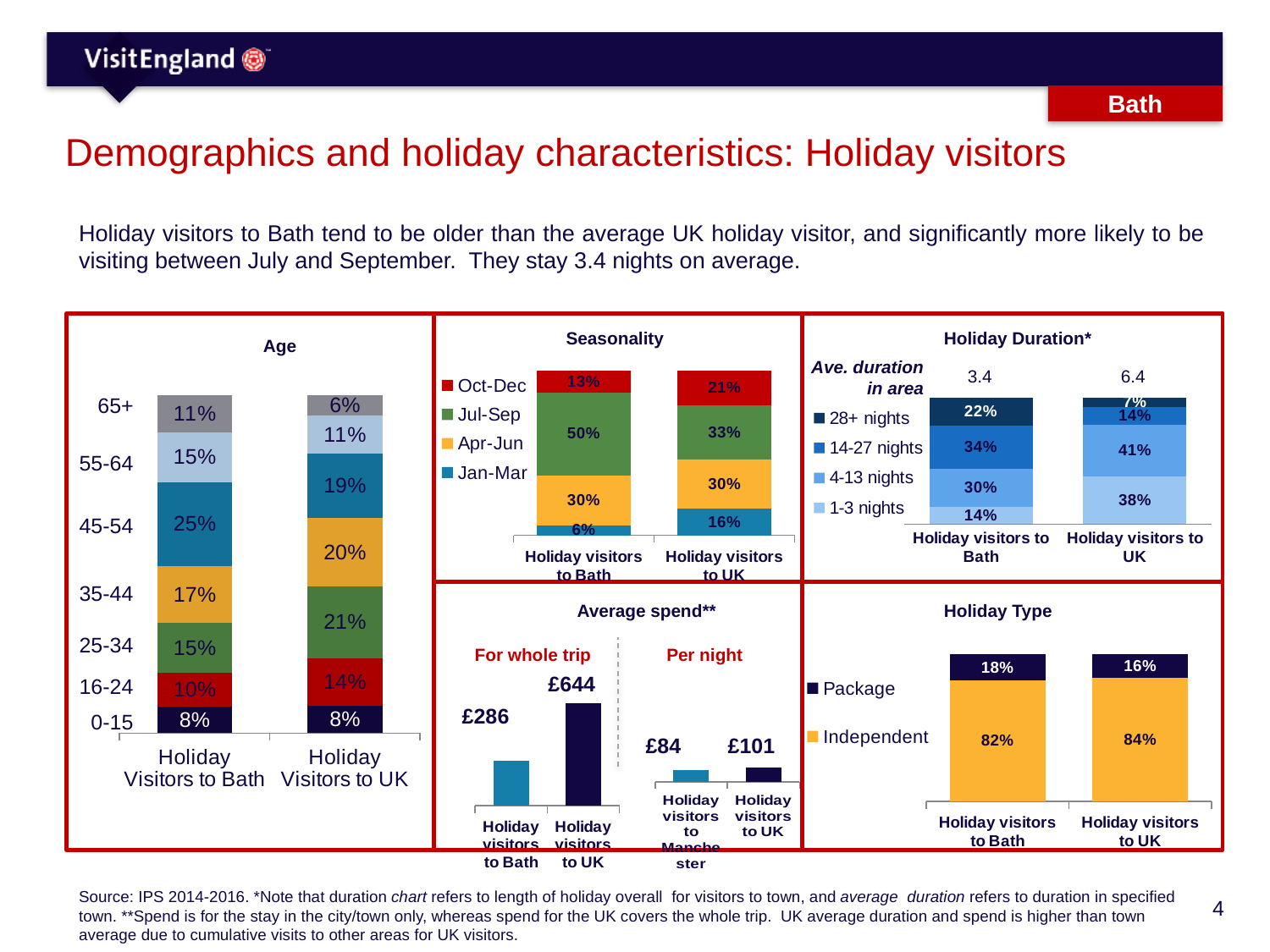
In the Holiday Duration chart, what is the average duration in area for holiday visitors to Bath? 3.4 In the Seasonality chart, which is larger: the Jan-Mar share for holiday visitors to Bath or for holiday visitors to UK? Holiday visitors to UK In the Average spend chart, what is the difference between the per night spend for holiday visitors to UK and the per night spend for the other bar? £17 What kind of chart is the Holiday Type chart? Stacked bar chart In the Holiday Type chart, what percentage of holiday visitors to Bath are on a package holiday? 18% In the Seasonality chart, what percentage of holiday visitors to Bath visit in Jul-Sep? 50% How many series does the legend of the Seasonality chart list? 4 In the Holiday Duration chart, what percentage of holiday visitors to UK stay 4-13 nights? 41% In the Age chart, what percentage of holiday visitors to Bath are aged 45-54? 25% In the Age chart, which age group is the largest for holiday visitors to UK? 25-34 In the Age chart, what is the difference between the 65+ share for holiday visitors to Bath and for holiday visitors to UK? 5% In the Average spend chart, what is the average spend for the whole trip for holiday visitors to UK? £644